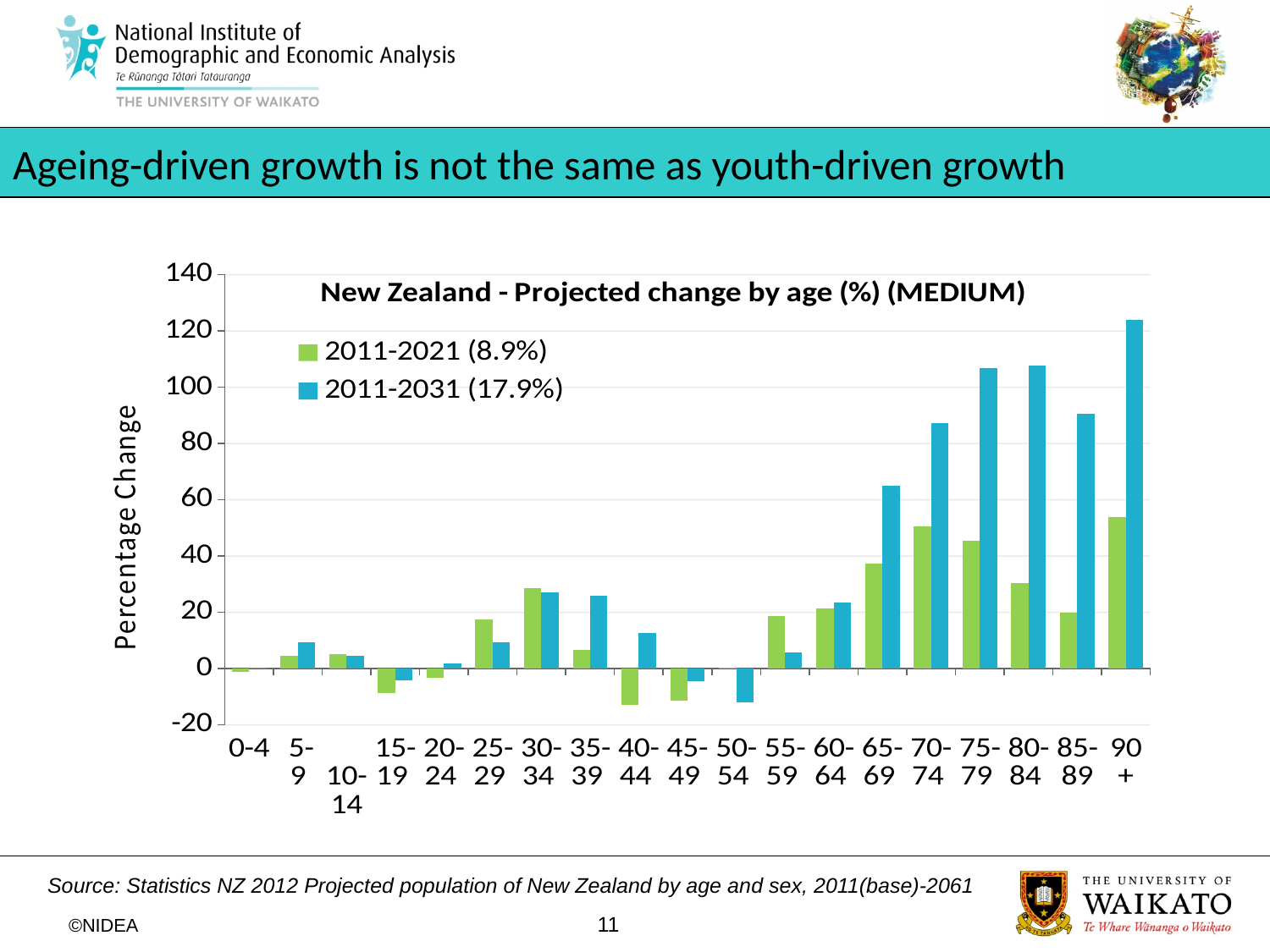
What is the title of the chart? New Zealand - Projected change by age (%) (MEDIUM) Is the 2011-2031 (17.9%) value for the 75-79 age group greater or less than 100? greater What are the two series named in the legend? 2011-2021 (8.9%) and 2011-2031 (17.9%) What type of chart is shown on the slide? bar chart For the 2011-2021 (8.9%) series, which is larger: the value for 80-84 or the value for 85-89? 80-84 Which age group has the highest value for the 2011-2031 (17.9%) series? 90+ How many series does the chart legend list? 2 How many age groups are shown on the x axis? 19 Is the 2011-2031 (17.9%) value for the 90+ age group greater or less than 100? greater For the 2011-2031 (17.9%) series, which is larger: the value for 80-84 or the value for 70-74? 80-84 Which age group has the lowest value for the 2011-2031 (17.9%) series? 50-54 Is the 2011-2021 (8.9%) value for the 65-69 age group greater or less than 40? less